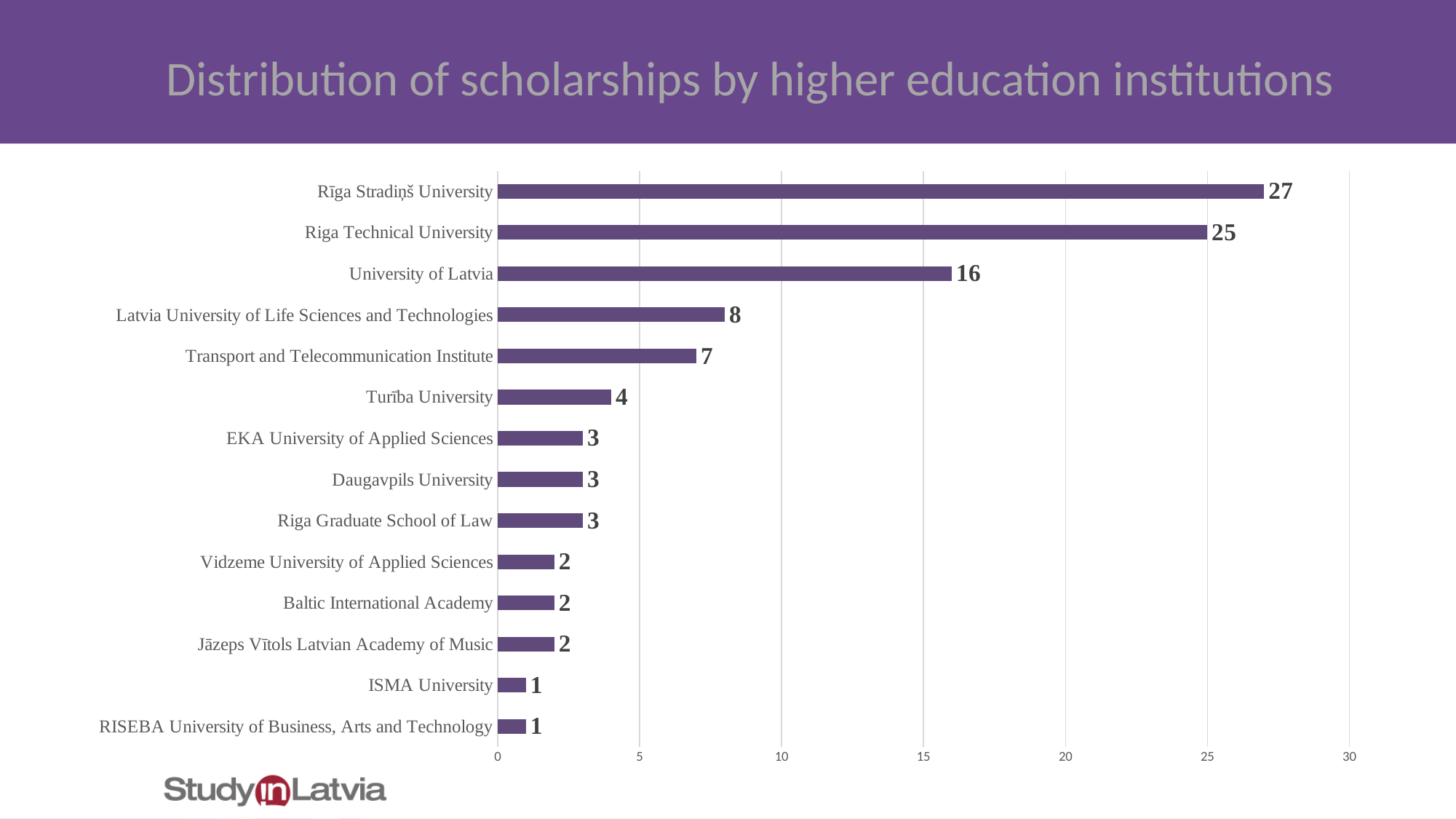
What is the difference between Riga Technical University and University of Latvia? 9 What kind of chart is shown on the slide? bar chart What is the value for Transport and Telecommunication Institute? 7 Which institution has the highest number of scholarships? Rīga Stradiņš University What is the title of the chart? Distribution of scholarships by higher education institutions How many institutions are shown in the chart? 14 Which is larger, the value for Latvia University of Life Sciences and Technologies or Turība University? Latvia University of Life Sciences and Technologies How many scholarships does Rīga Stradiņš University have? 27 What is the value for University of Latvia? 16 What is the difference between Rīga Stradiņš University and Riga Technical University? 2 What is the value for Daugavpils University? 3 Is the value for University of Latvia greater or less than 15? greater